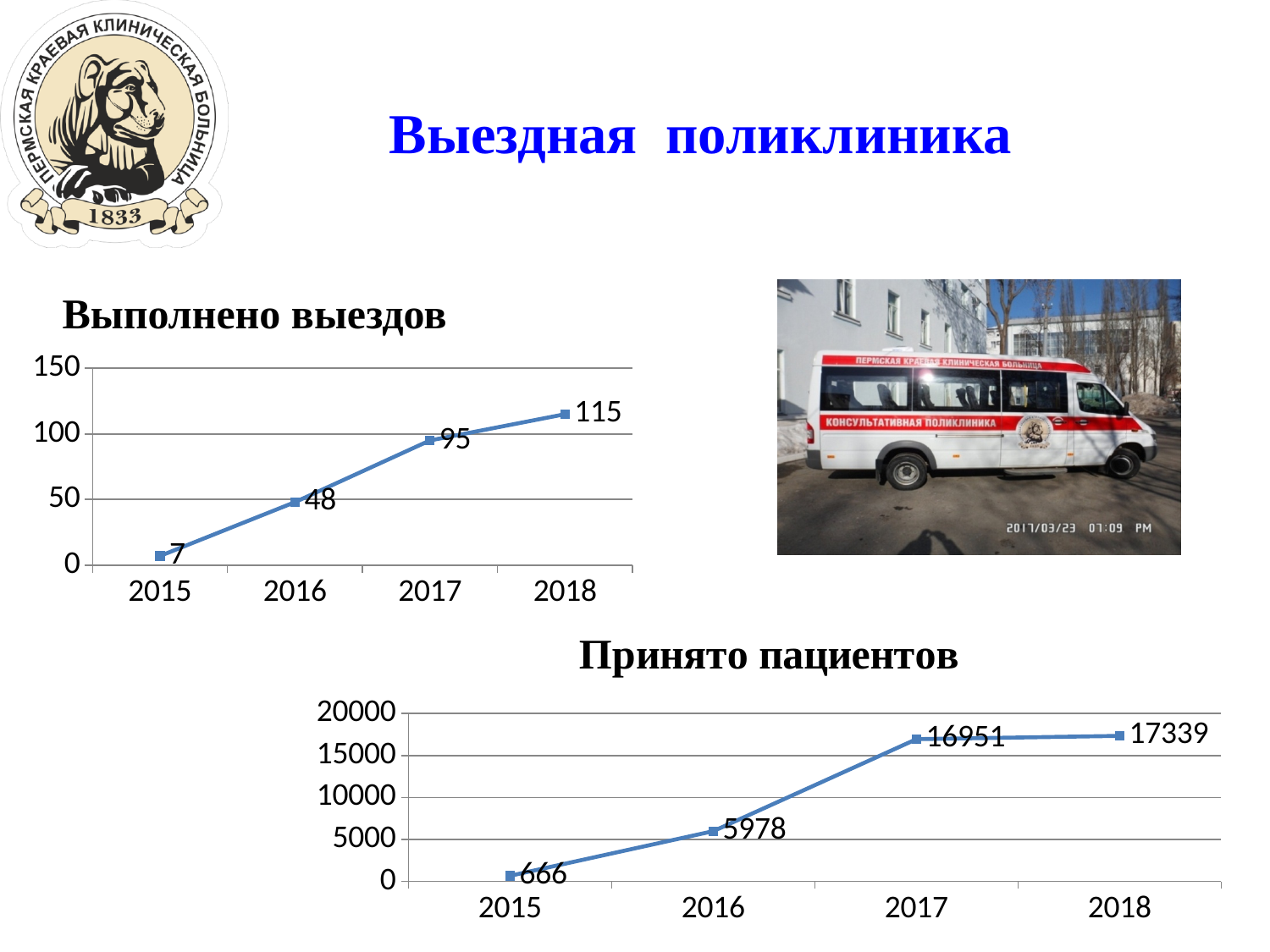
In the 'Выполнено выездов' chart, what is the difference between the values for 2018 and 2016? 67 In the 'Выполнено выездов' chart, what is the value for 2017? 95 In the 'Выполнено выездов' chart, how many data points are plotted? 4 In the 'Выполнено выездов' chart, do the values rise or fall from 2015 to 2018? rise In the 'Принято пациентов' chart, what is the value for 2018? 17339 In the 'Принято пациентов' chart, which year has the lowest value? 2015 What kind of chart is the 'Принято пациентов' chart? line chart In the 'Принято пациентов' chart, what is the difference between the values for 2017 and 2016? 10973 In the 'Выполнено выездов' chart, which year has the highest value? 2018 In the 'Принято пациентов' chart, what is the value for 2016? 5978 In the 'Выполнено выездов' chart, what is the value for 2015? 7 In the 'Принято пациентов' chart, is the value for 2017 greater or less than 15000? greater